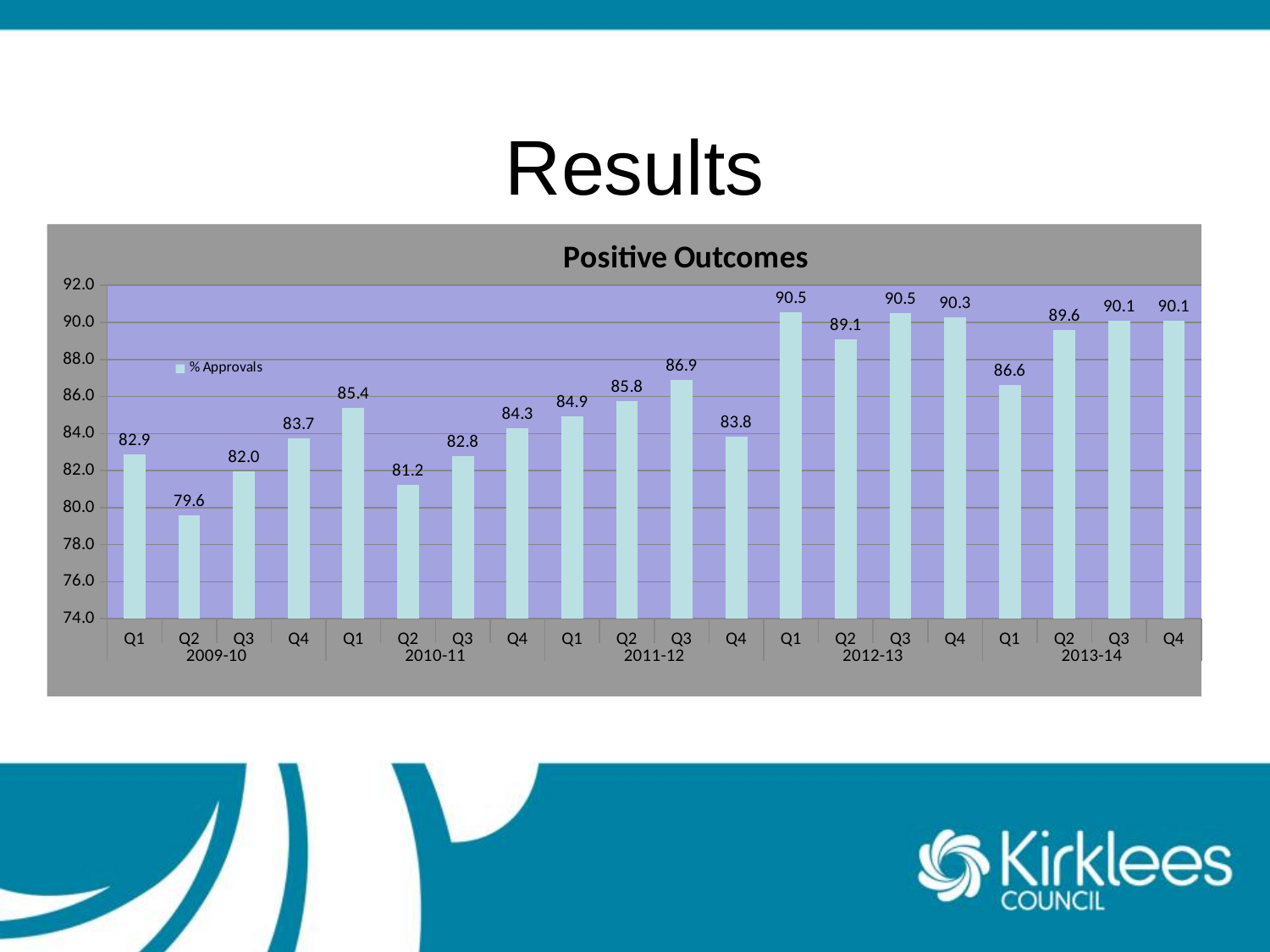
Which is larger, the % Approvals value for Q2 of 2010-11 or Q2 of 2011-12? Q2 2011-12 What is the title of the chart? Positive Outcomes What is the difference between the % Approvals values for Q1 of 2012-13 and Q1 of 2009-10? 7.6 Which quarter has the lowest % Approvals value? Q2 2009-10 What is the % Approvals value for Q4 of 2013-14? 90.1 Do the % Approvals values generally rise or fall from 2009-10 to 2013-14? Rise What type of chart is shown on the slide? Bar chart What is the % Approvals value for Q3 of 2011-12? 86.9 How many series does the legend list? 1 Is the % Approvals value for Q1 of 2013-14 greater or less than 88.0? less What is the % Approvals value for Q2 of 2009-10? 79.6 How many bars are plotted in the chart? 20